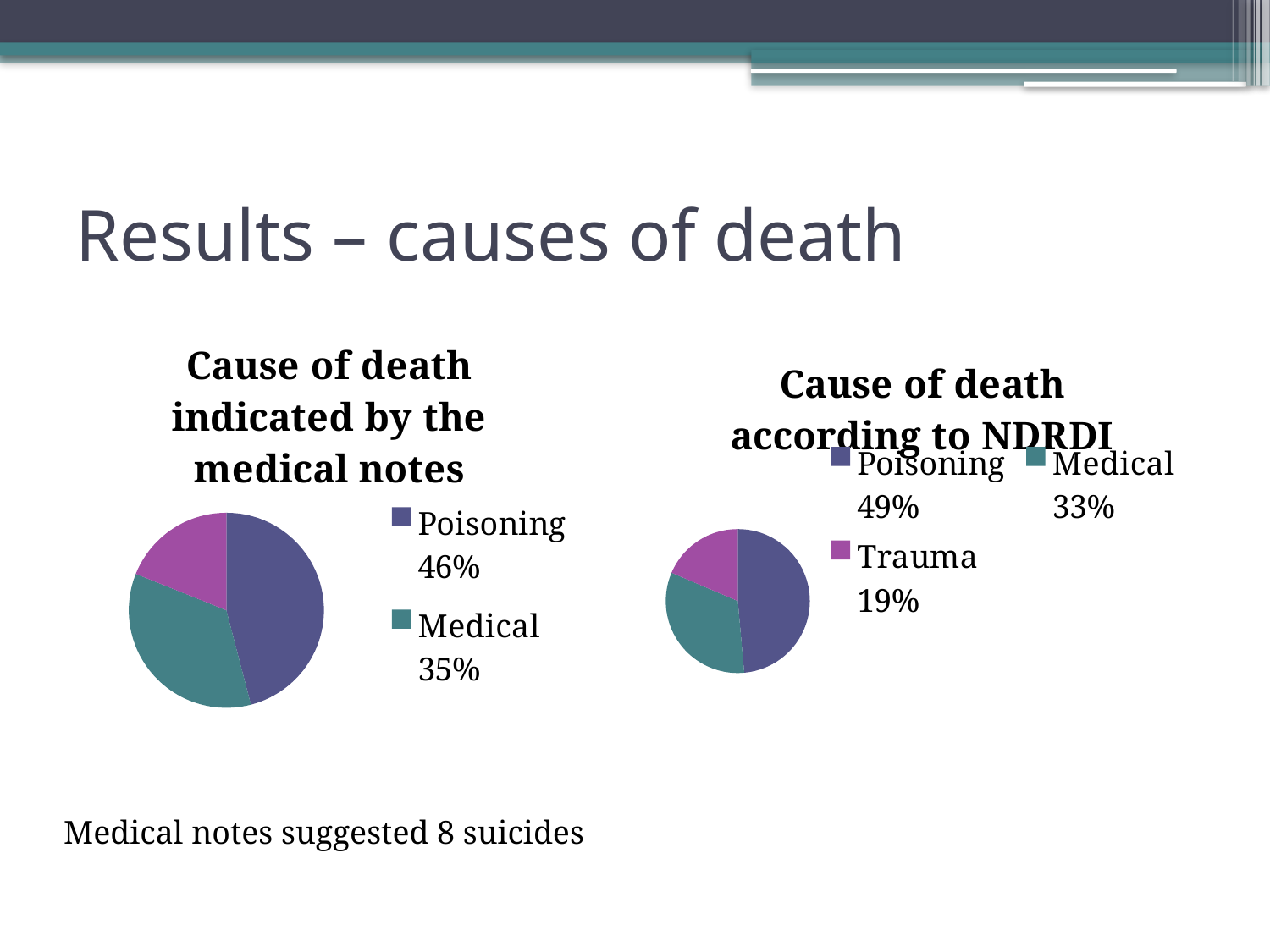
In the chart titled "Cause of death according to NDRDI", what share of deaths is attributed to Medical causes? 33% In the chart titled "Cause of death according to NDRDI", what share of deaths is attributed to Poisoning? 49% What type of chart is used on the right-hand side of the slide, titled "Cause of death according to NDRDI"? Pie chart Is the Poisoning share larger in the chart titled "Cause of death indicated by the medical notes" or in the chart titled "Cause of death according to NDRDI"? Cause of death according to NDRDI In the chart titled "Cause of death according to NDRDI", how many percentage points larger is the Poisoning share than the Medical share? 16 percentage points In the chart titled "Cause of death according to NDRDI", what share of deaths is attributed to Trauma? 19% In the chart titled "Cause of death indicated by the medical notes", how many percentage points larger is the Poisoning share than the Medical share? 11 percentage points In the chart titled "Cause of death according to NDRDI", which cause of death has the largest share? Poisoning In the chart titled "Cause of death according to NDRDI", which cause of death has the smallest share? Trauma In the chart titled "Cause of death according to NDRDI", how many causes of death are listed in the legend? 3